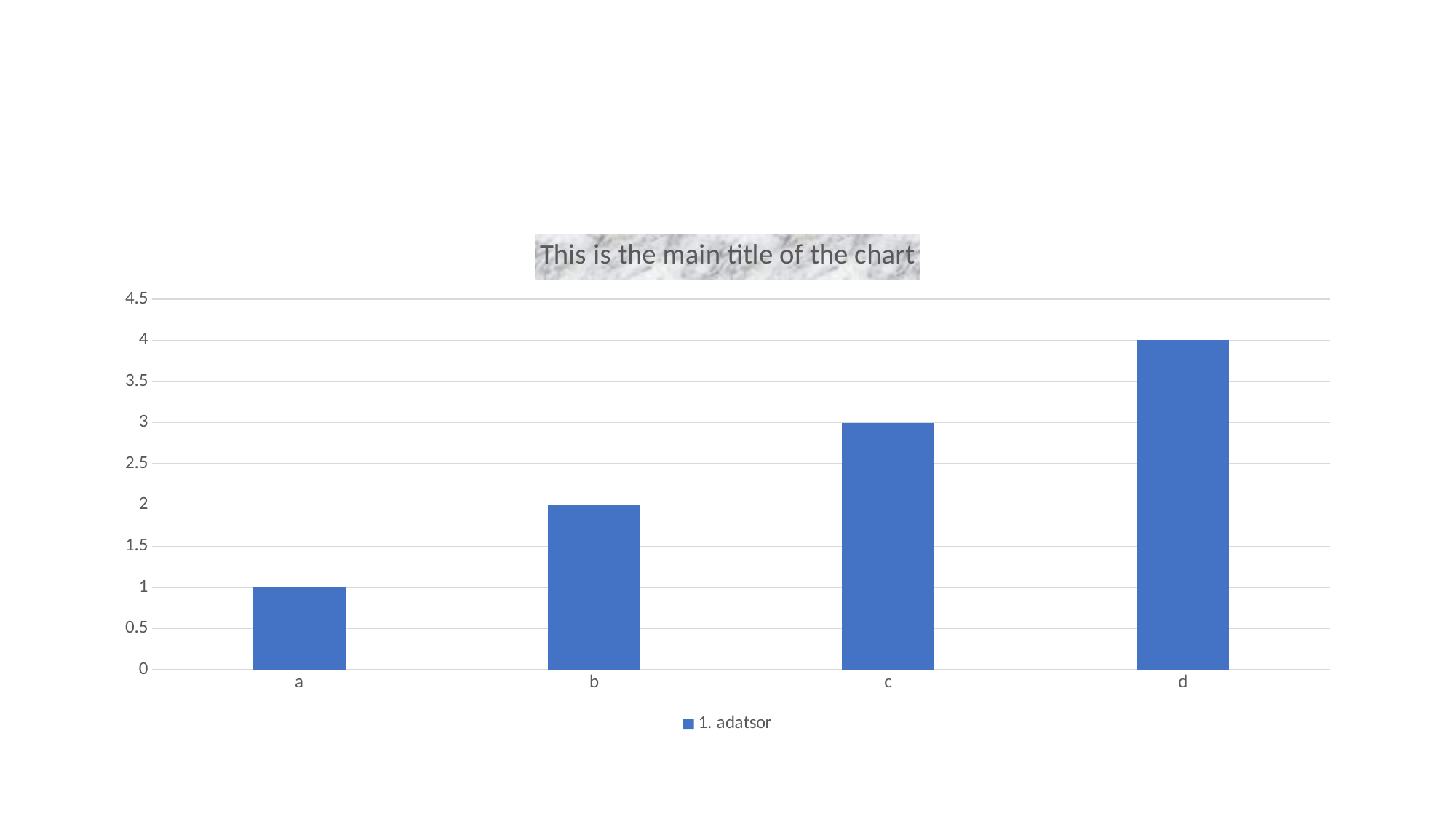
Which category has the highest value? d How many categories are shown on the x axis? 4 Which is larger, the value for b or the value for c? c Do the values rise or fall from a to d along the x axis? rise What is the title of the chart? This is the main title of the chart What is the value for category d? 4 What is the name of the series shown in the legend? 1. adatsor What type of chart is shown on the slide? bar chart What is the difference between the values for d and b? 2 What is the value for category a? 1 Which category has the lowest value? a How many series does the legend list? 1